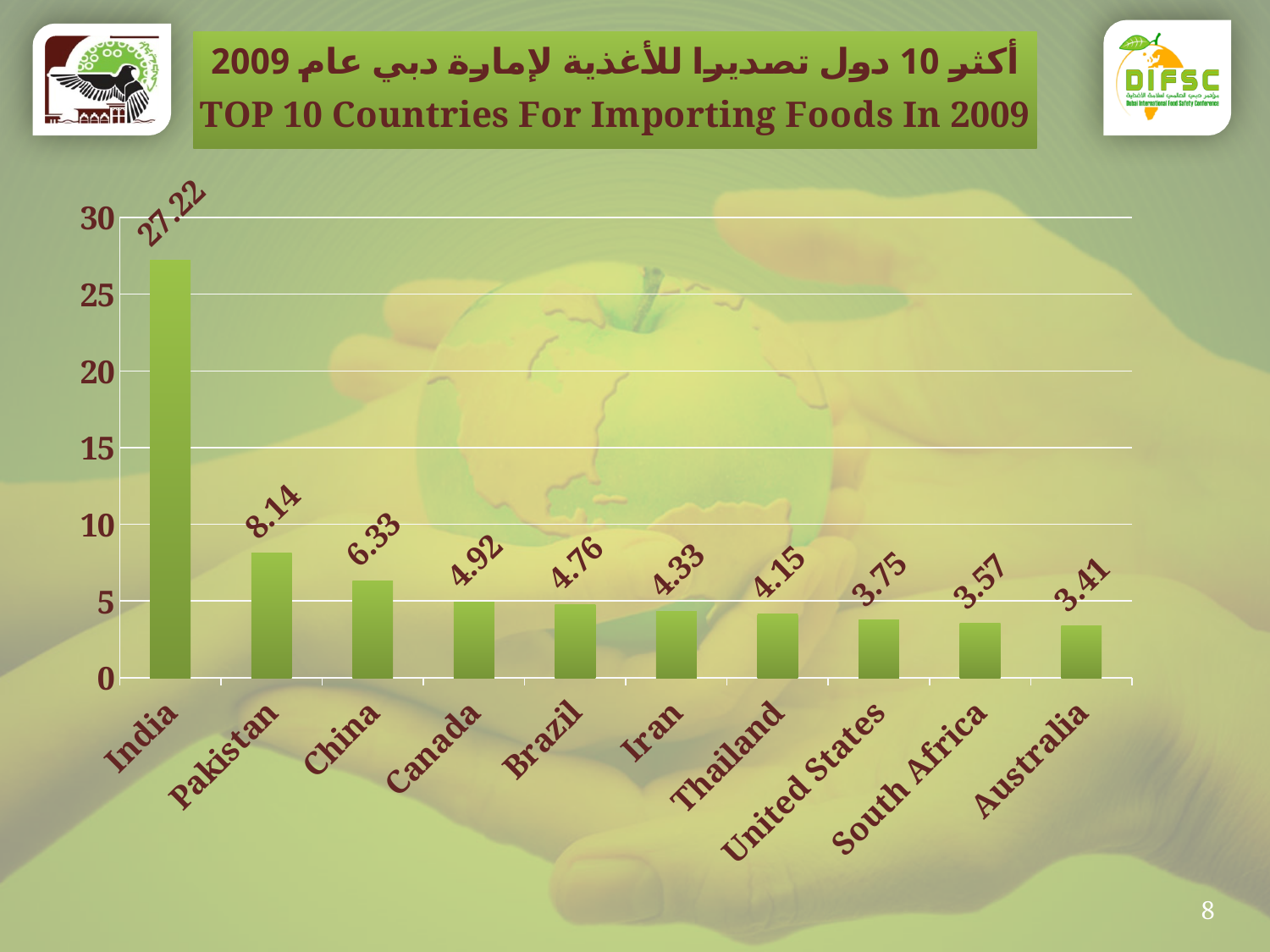
Is the value for China greater or less than 5? greater What is the difference between the values for India and Pakistan? 19.08 What is the value for Pakistan? 8.14 What is the value for Thailand? 4.15 Which is larger, the value for Brazil or the value for Iran? Brazil What is the English title of the chart? TOP 10 Countries For Importing Foods In 2009 What is the difference between the values for China and Canada? 1.41 How many countries are shown in the chart? 10 Which country has the lowest value? Australia What kind of chart is shown on the slide? bar chart What is the value for India? 27.22 Which country has the highest value? India